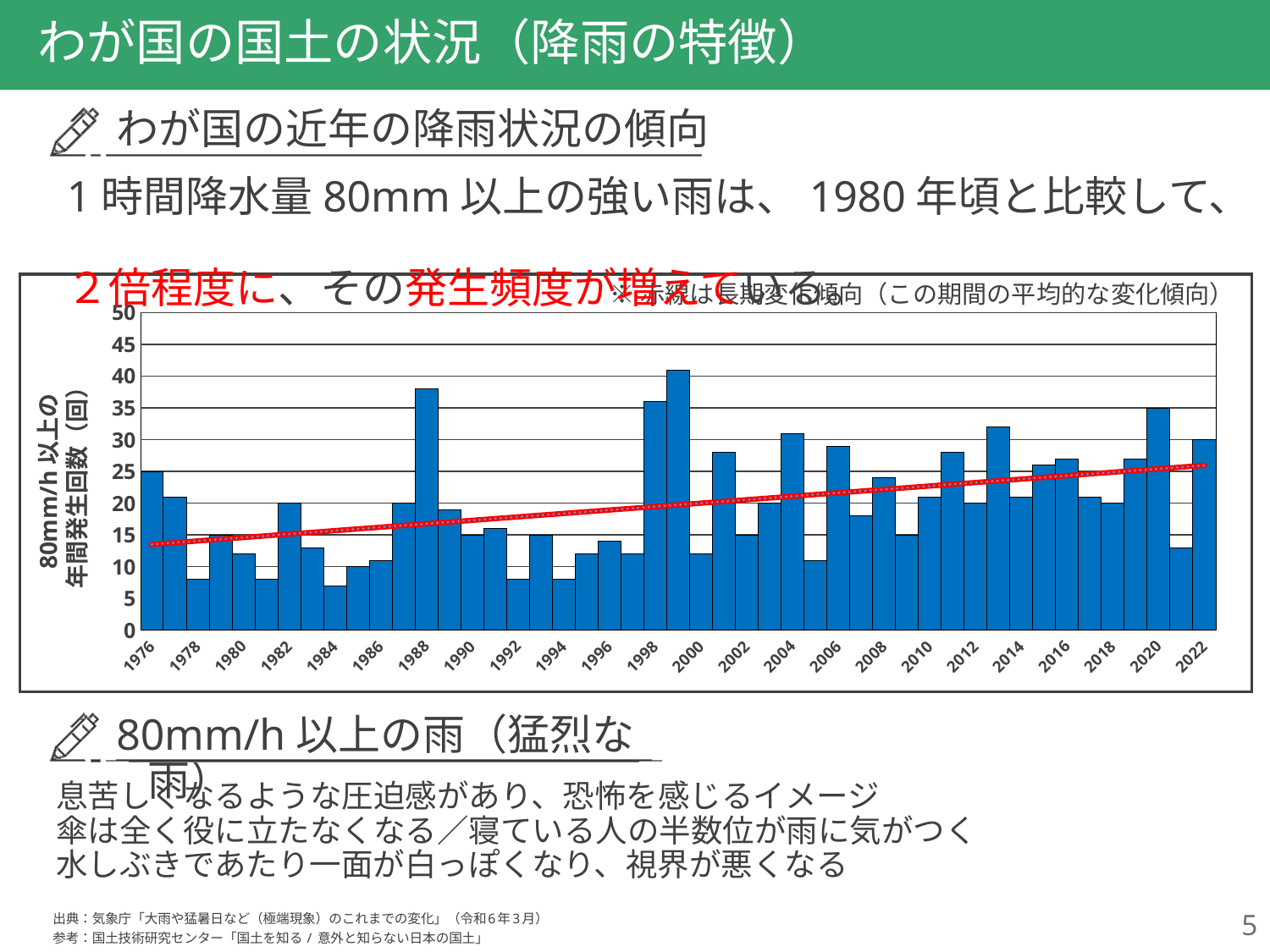
Is the value for 2000 greater or less than 15? less Is the value for 1988 greater or less than 35? greater Which year has the highest number of annual occurrences of 80mm/h or more rainfall? 1999 Which year has the larger value, 1999 or 2020? 1999 What is the first year shown on the x axis? 1976 What kind of chart is shown on the slide? bar chart Is the value for 2022 greater or less than 25? greater Which year has the larger value, 2004 or 2005? 2004 According to the red trend line, do the values rise or fall from 1976 to 2022? rise What is the maximum value shown on the y axis? 50